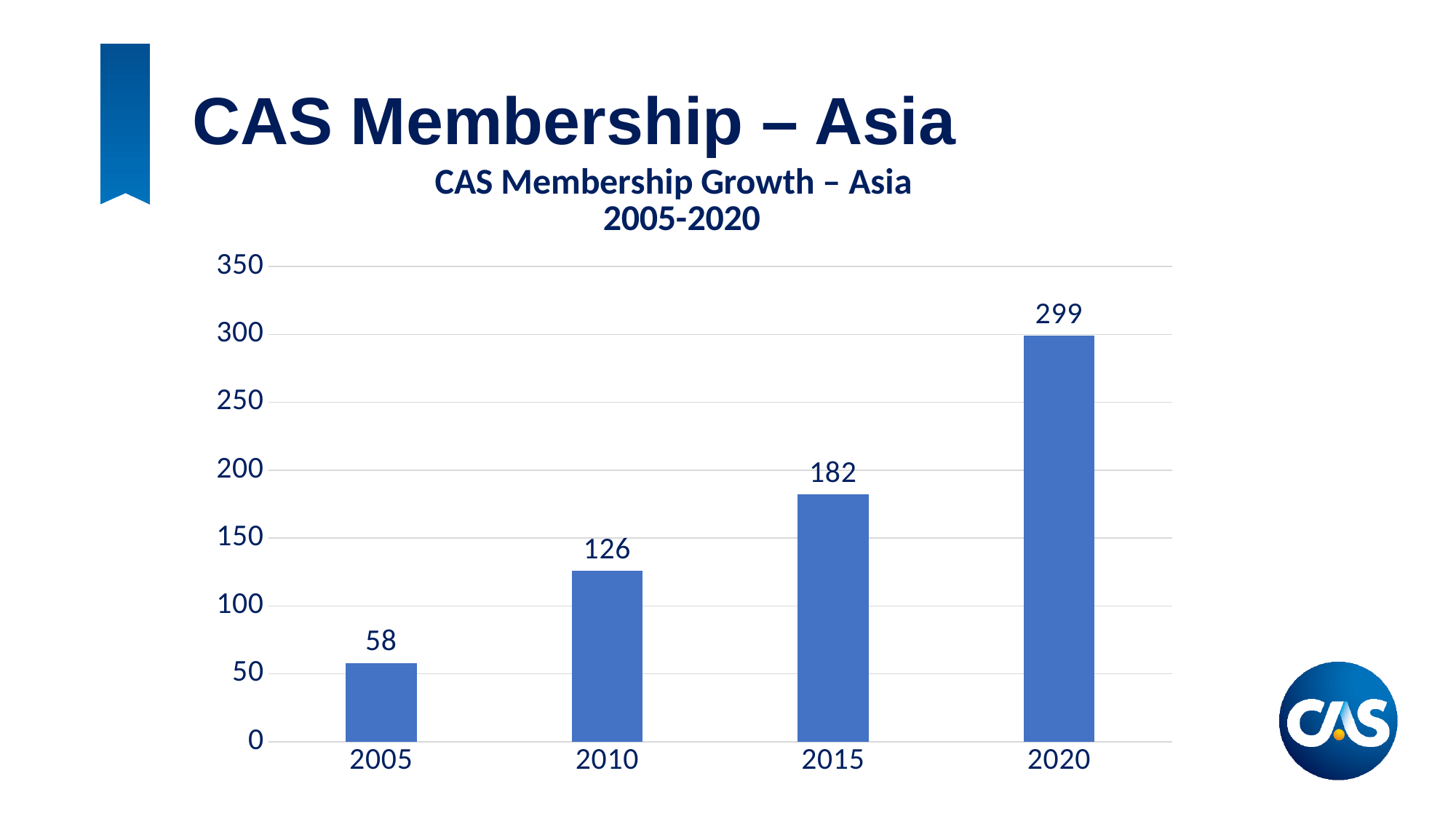
Which year has the highest CAS membership in Asia? 2020 What is the CAS membership in Asia for 2020? 299 Which year has the lowest CAS membership in Asia? 2005 Which year has a larger CAS membership in Asia, 2010 or 2015? 2015 What is the CAS membership in Asia for 2015? 182 What is the difference in CAS membership in Asia between 2010 and 2005? 68 What is the difference in CAS membership in Asia between 2020 and 2015? 117 What is the CAS membership in Asia for 2010? 126 What is the CAS membership in Asia for 2005? 58 Does CAS membership in Asia rise or fall from 2005 to 2020? Rise How many years are shown on the chart? 4 What kind of chart is shown on the slide? Bar chart